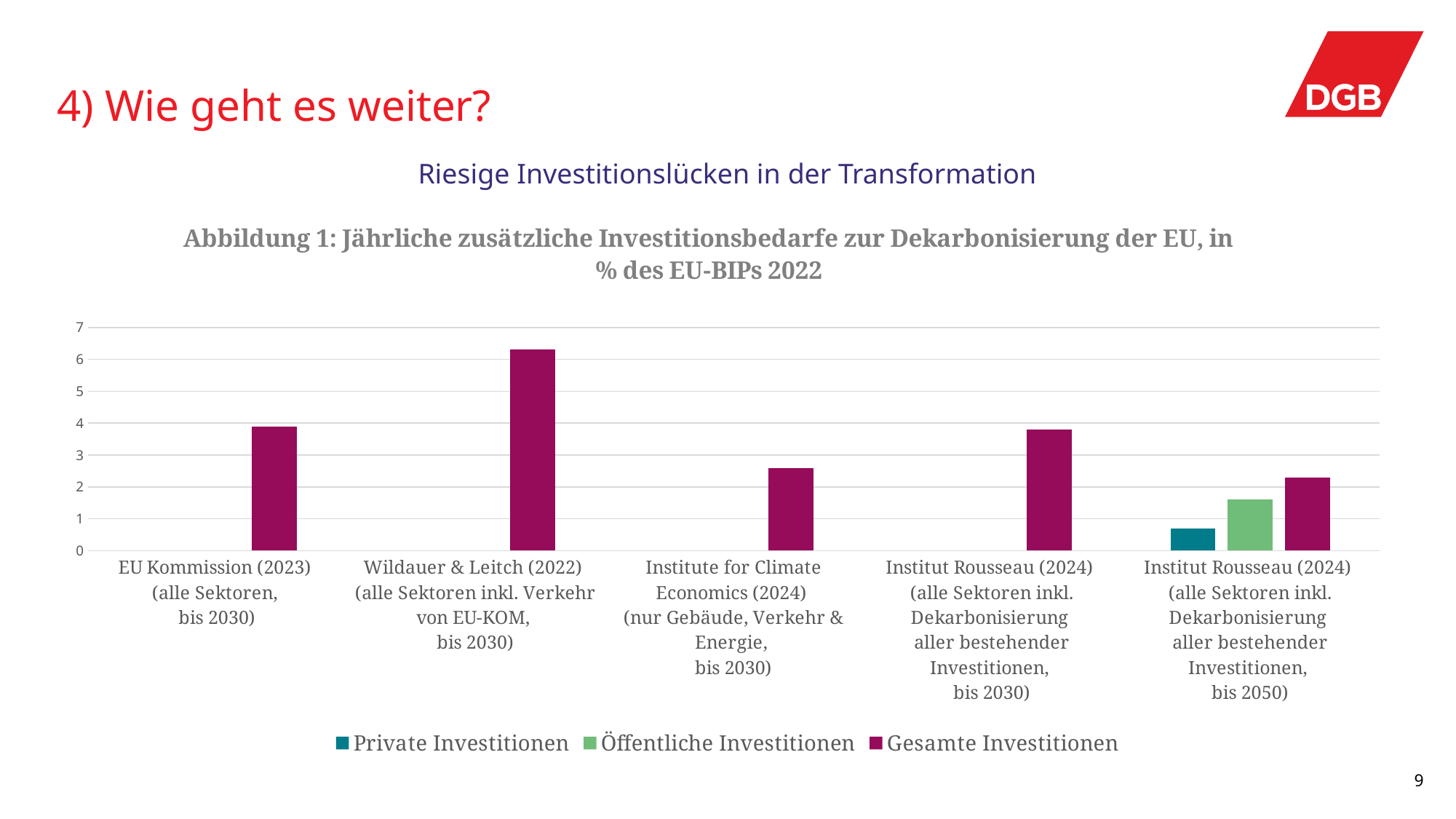
Which category has the highest value for Gesamte Investitionen? Wildauer & Leitch (2022) How many series does the legend list? 3 Is the value for Private Investitionen for Institut Rousseau (2024, bis 2050) greater or less than 1? less Is the value for Öffentliche Investitionen for Institut Rousseau (2024, bis 2050) greater or less than 1? greater Which is larger for Institut Rousseau (2024, bis 2050): Private Investitionen or Öffentliche Investitionen? Öffentliche Investitionen Is the value for Gesamte Investitionen for EU Kommission (2023) greater or less than 4? less Which is larger for Gesamte Investitionen: Wildauer & Leitch (2022) or Institute for Climate Economics (2024)? Wildauer & Leitch (2022) How many categories are shown on the x axis? 5 Which category is the only one that shows bars for all three series? Institut Rousseau (2024) (bis 2050) What kind of chart is shown on the slide? bar chart